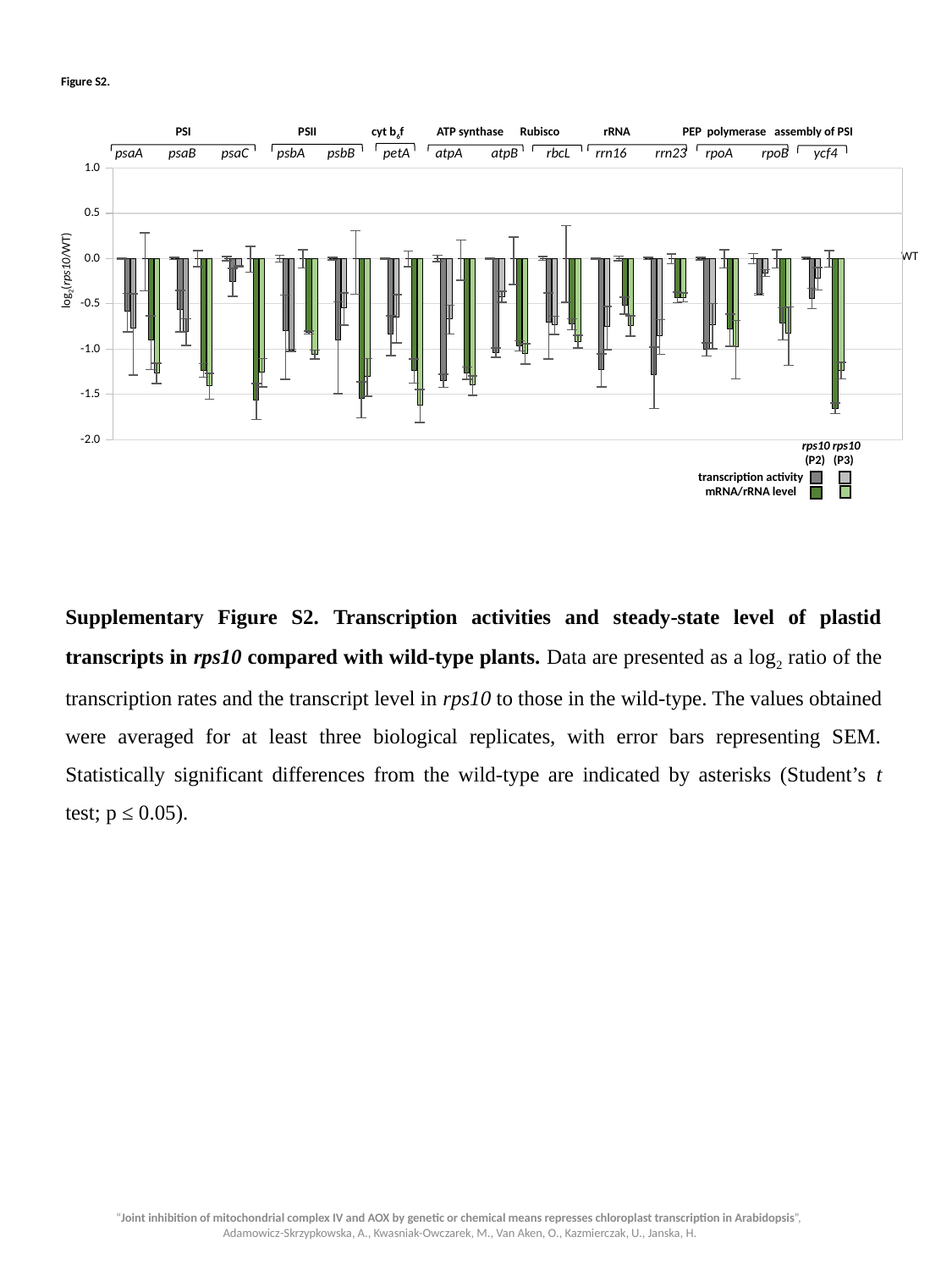
How many series does the chart's legend list? 4 Is the transcription activity value for rpoB in rps10 (P3) greater or less than -0.5? greater What is the label on the y axis of the chart? log2(rps10/WT) Is the mRNA/rRNA level value for ycf4 in rps10 (P2) greater or less than -1.0? less Is the transcription activity value for atpA in rps10 (P2) greater or less than -1.0? less What kind of chart is shown on the slide? bar chart Which functional group heading covers the genes psaA, psaB and psaC? PSI Which has the larger transcription activity value in rps10 (P2), psaA or psaC? psaC How many genes are shown along the x axis of the chart? 14